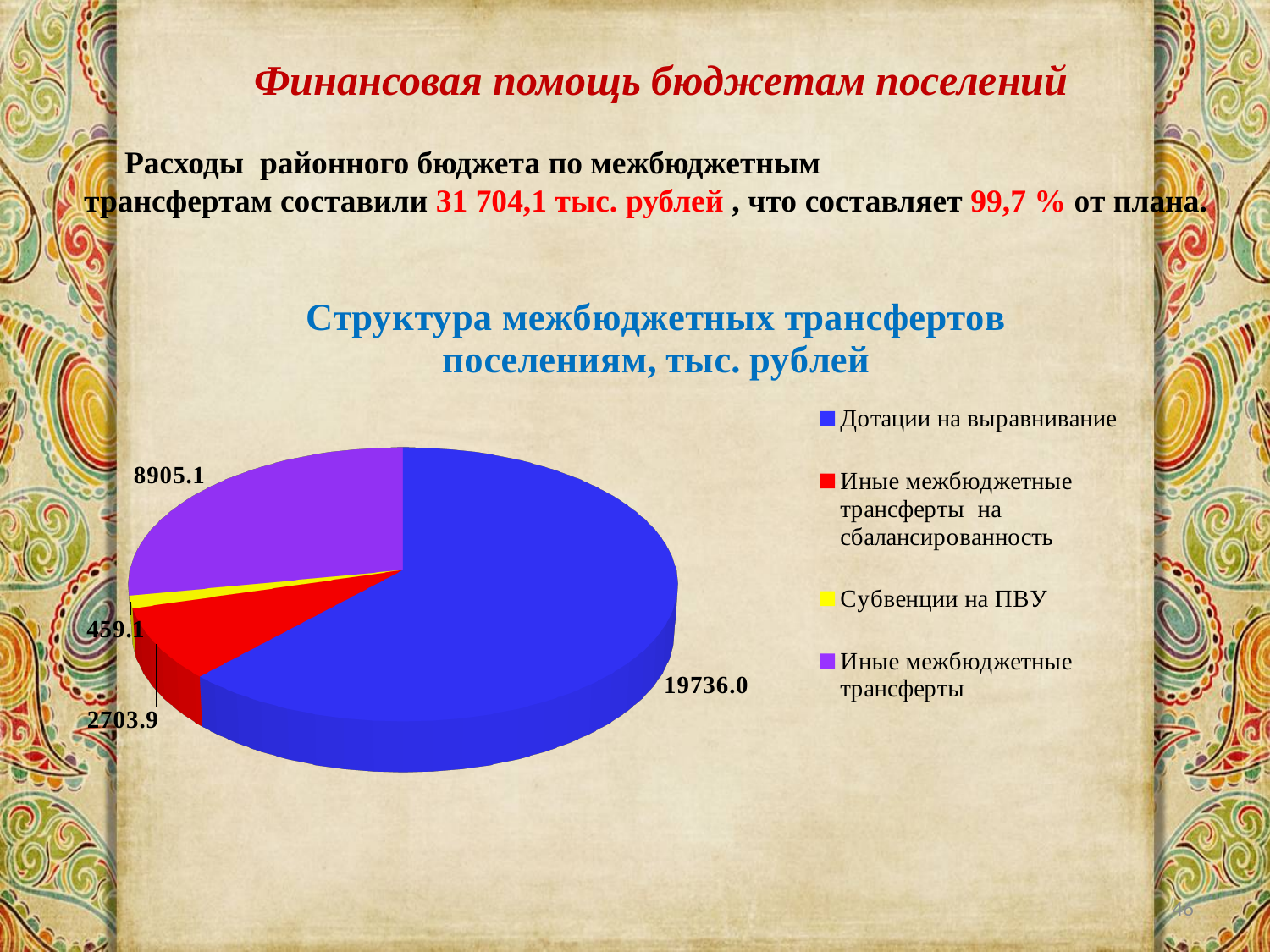
What is the value for Дотации на выравнивание? 19736.0 Which category has the smallest slice of the pie? Субвенции на ПВУ How many categories does the pie chart have? 4 What colour is the slice for Субвенции на ПВУ? yellow What is the value for Иные межбюджетные трансферты (the purple slice)? 8905.1 What type of chart is shown on the slide? pie chart What is the difference between the values for Иные межбюджетные трансферты на сбалансированность and Субвенции на ПВУ? 2244.8 What is the difference between the values for Дотации на выравнивание and Иные межбюджетные трансферты? 10830.9 What is the value for Иные межбюджетные трансферты на сбалансированность? 2703.9 Which is larger: Иные межбюджетные трансферты or Иные межбюджетные трансферты на сбалансированность? Иные межбюджетные трансферты Which category has the largest slice of the pie? Дотации на выравнивание What is the value for Субвенции на ПВУ? 459.1